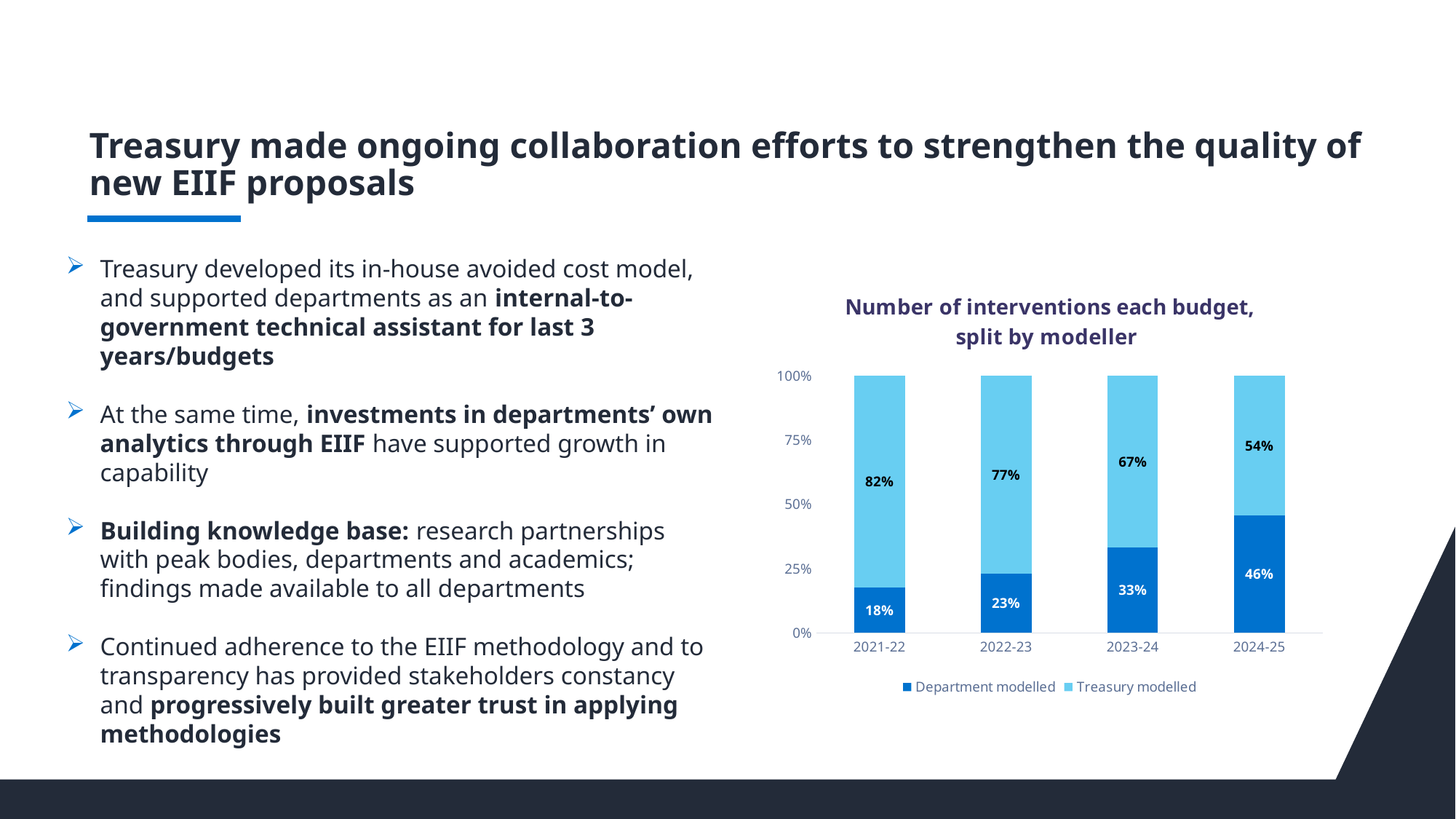
What is the Department modelled share for 2024-25? 46% How many budget years are shown on the x axis? 4 What is the Department modelled share for 2021-22? 18% What is the Treasury modelled share for 2022-23? 77% Which budget year has the lowest Treasury modelled share? 2024-25 Does the Department modelled share rise or fall from 2021-22 to 2024-25? Rise How many series does the legend list? 2 What is the Treasury modelled share for 2023-24? 67% Which is larger in 2023-24: the Department modelled share or the Treasury modelled share? Treasury modelled What kind of chart is shown on the slide? Stacked bar chart Which budget year has the highest Department modelled share? 2024-25 What is the difference between the Treasury modelled share in 2021-22 and in 2024-25? 28%